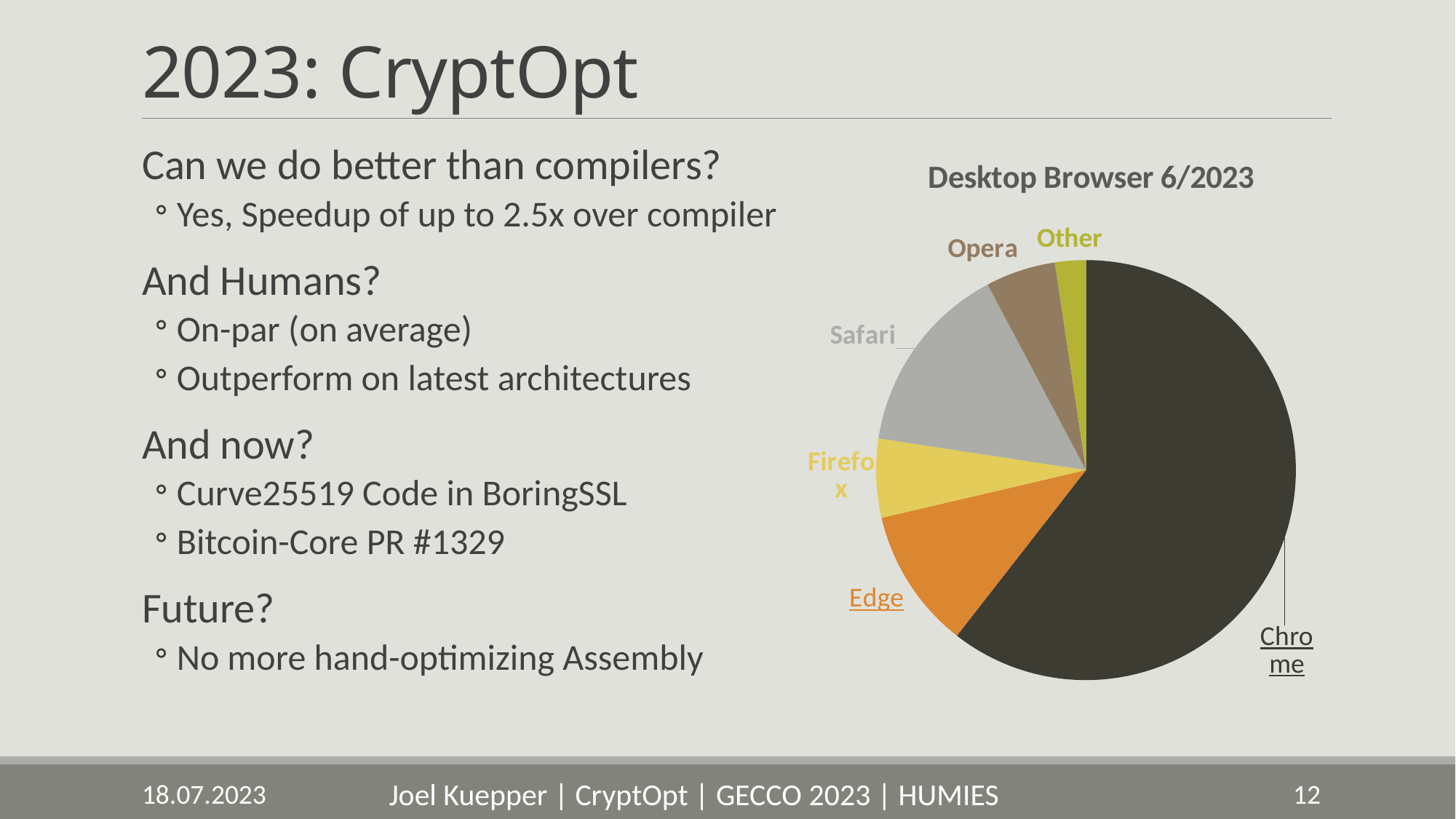
Which category has the smallest slice in the pie chart? Other Which slice is larger, Chrome or Edge? Chrome How many slices does the pie chart have? 6 Which browser has the largest slice in the pie chart? Chrome Which slice is larger, Firefox or Other? Firefox Which slice is larger, Edge or Firefox? Edge What kind of chart is shown on the slide? pie chart Which browser's slice is coloured orange in the pie chart? Edge What is the title of the chart? Desktop Browser 6/2023